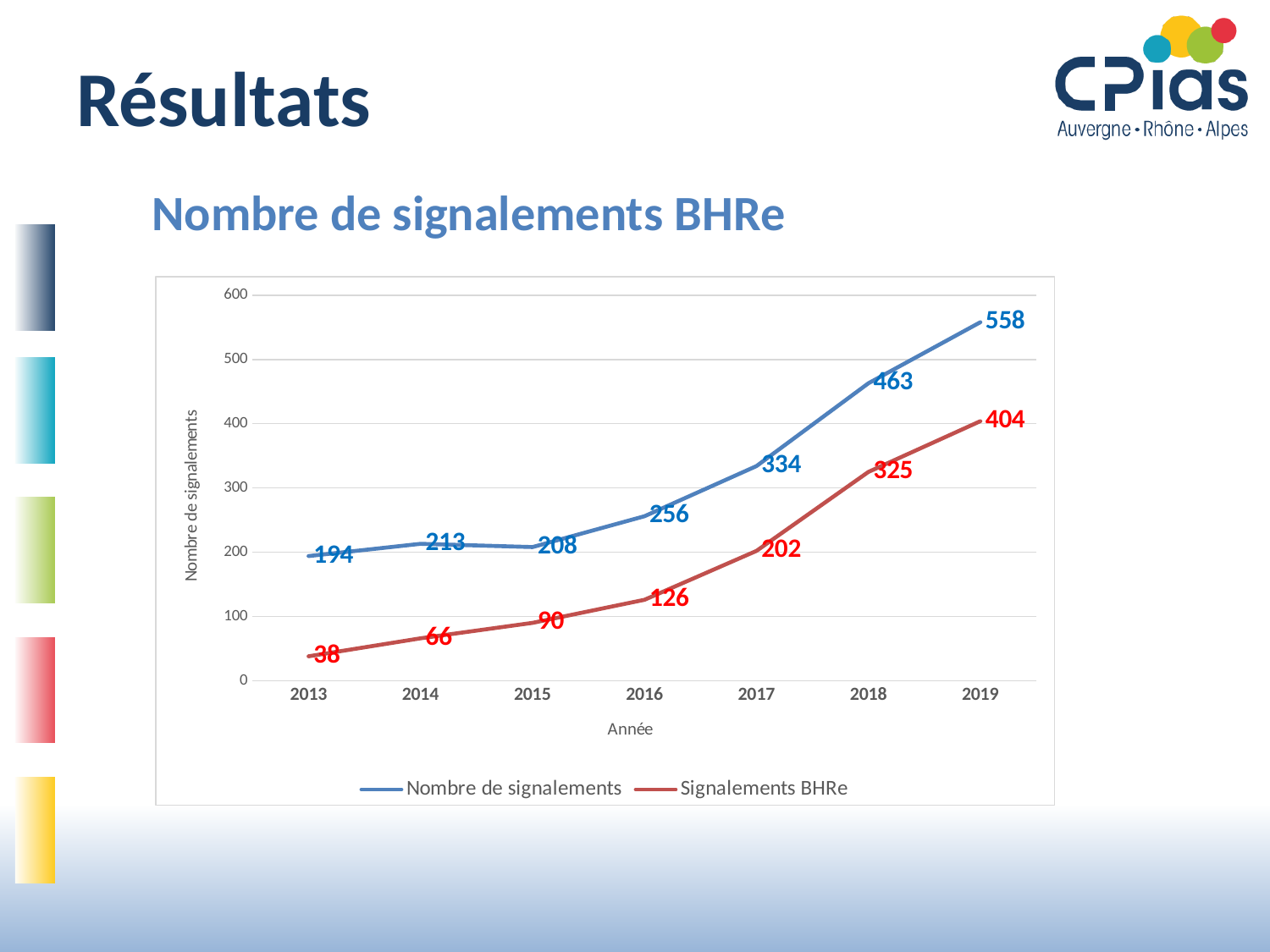
What is the title of the chart? Nombre de signalements BHRe What is the value of "Nombre de signalements" in 2019? 558 Does "Signalements BHRe" rise or fall from 2013 to 2019? Rise In which year is "Nombre de signalements" highest? 2019 How many years are shown on the x axis? 7 What is the value of "Signalements BHRe" in 2013? 38 In which year is "Nombre de signalements" lowest? 2013 What is the value of "Signalements BHRe" in 2017? 202 What kind of chart is shown? Line chart Which is larger: "Signalements BHRe" in 2018 or "Nombre de signalements" in 2016? Signalements BHRe in 2018 How many series does the legend list? 2 What is the difference between "Nombre de signalements" and "Signalements BHRe" in 2019? 154